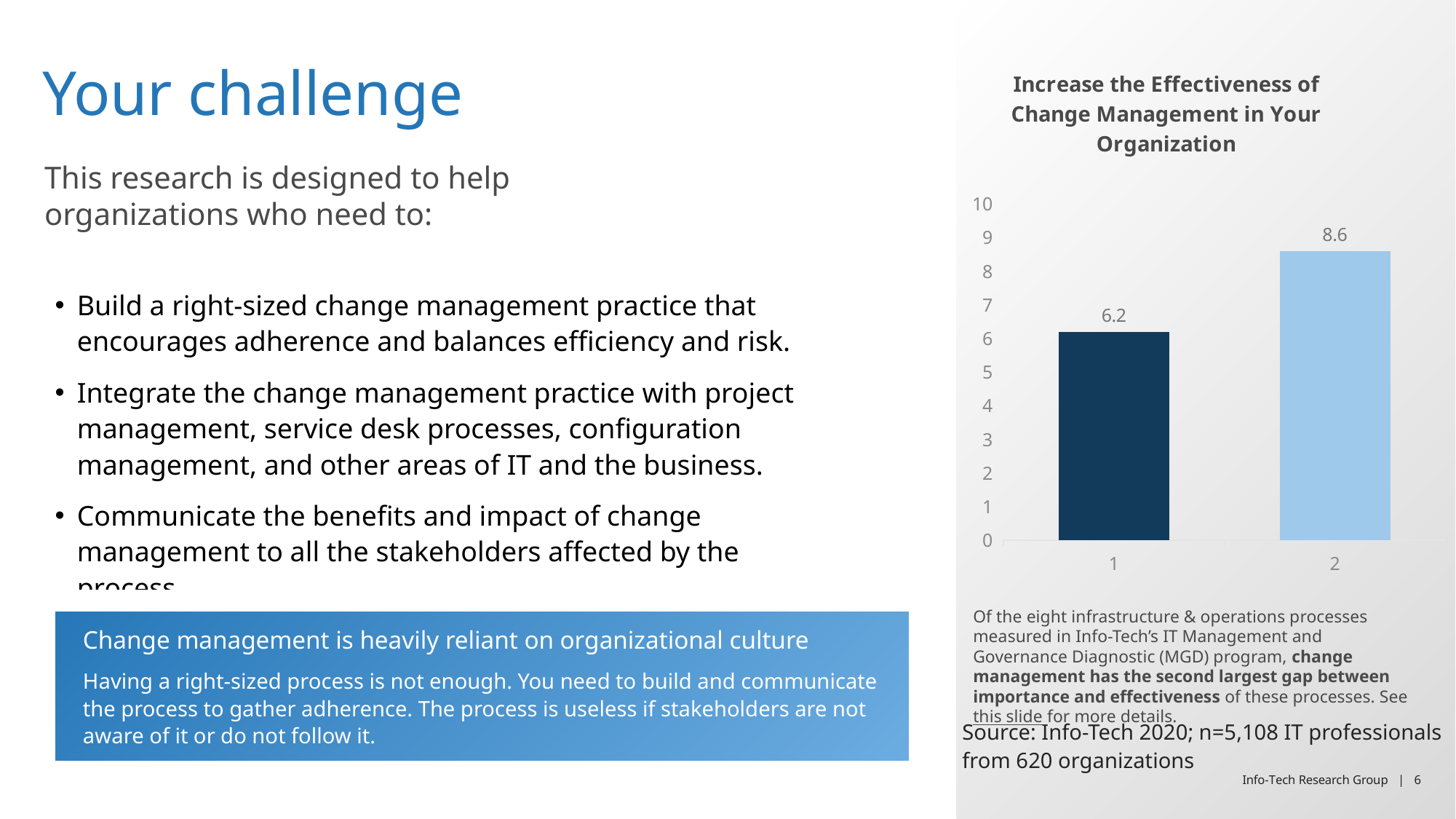
How many bars are plotted in the chart? 2 Which is larger, the value for category 1 or category 2? category 2 What kind of chart is shown on the slide? bar chart Is the value for category 1 greater or less than 7? less What is the title of the chart? Increase the Effectiveness of Change Management in Your Organization Do the values rise or fall from category 1 to category 2? rise What is the difference between the values for category 2 and category 1? 2.4 Which category has the lowest value? 1 What is the value of the bar for category 2? 8.6 Which category has the highest value? 2 What is the value of the bar for category 1? 6.2 Is the value for category 2 greater or less than 8? greater